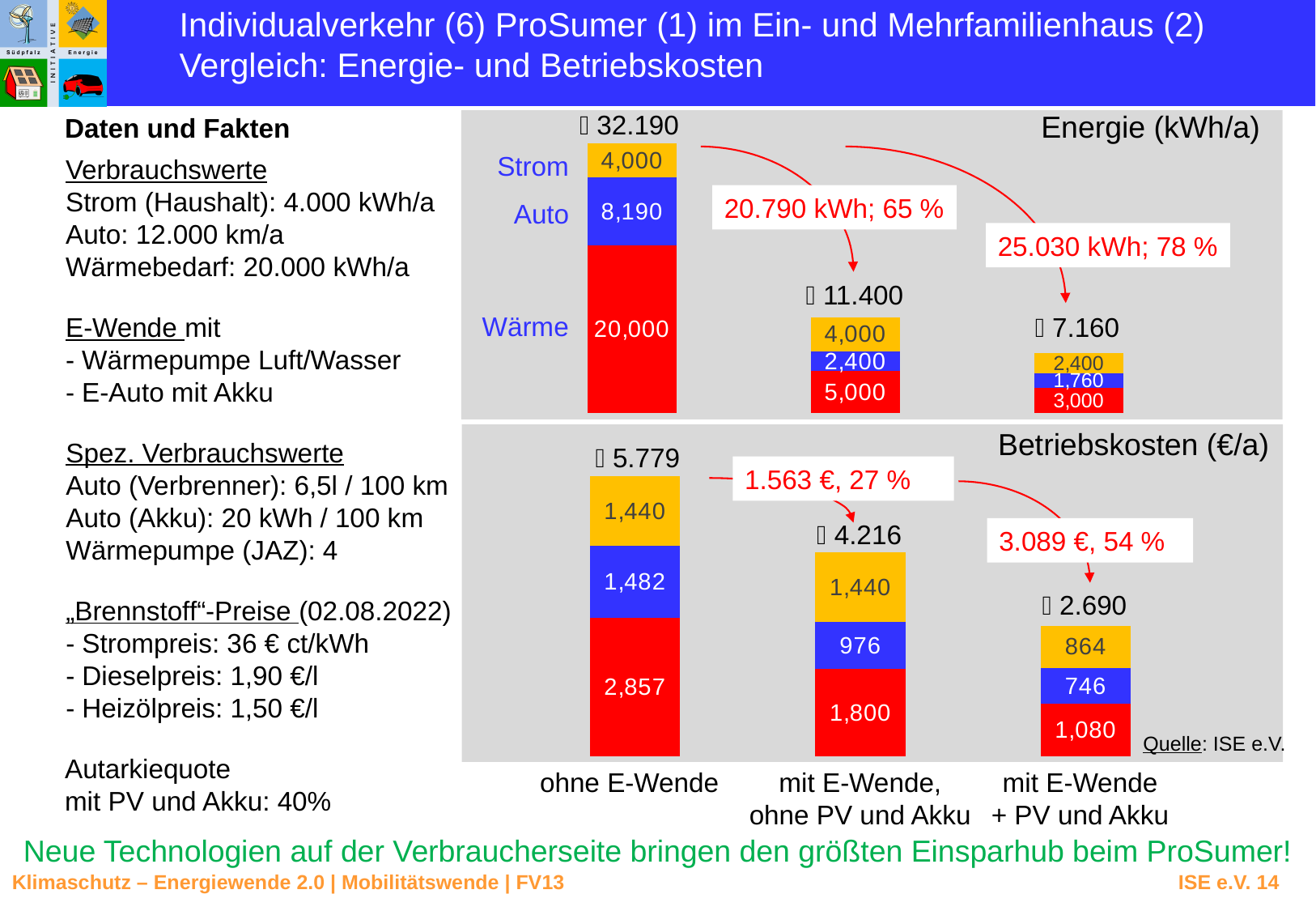
In the Betriebskosten (€/a) chart, which category has the lowest total? mit E-Wende + PV und Akku In the Energie (kWh/a) chart, which category has the highest total? ohne E-Wende In the Energie (kWh/a) chart, what is the Wärme value for 'ohne E-Wende'? 20,000 In the Betriebskosten (€/a) chart, what is the Wärme value for 'mit E-Wende, ohne PV und Akku'? 1,800 In the Energie (kWh/a) chart, what is the Auto value for 'mit E-Wende, ohne PV und Akku'? 2,400 In the Energie (kWh/a) chart, is the Wärme value larger for 'ohne E-Wende' or for 'mit E-Wende + PV und Akku'? ohne E-Wende In the Energie (kWh/a) chart, what is the total shown above the 'mit E-Wende + PV und Akku' bar? 7.160 In the Betriebskosten (€/a) chart, what is the difference between the Auto values for 'ohne E-Wende' and 'mit E-Wende, ohne PV und Akku'? 506 In the Betriebskosten (€/a) chart, what is the total shown above the 'ohne E-Wende' bar? 5.779 What type of chart is used for the Energie (kWh/a) data? Stacked bar chart How many categories are shown along the x axis of the charts? 3 In the Betriebskosten (€/a) chart, what is the Strom value for 'mit E-Wende + PV und Akku'? 864